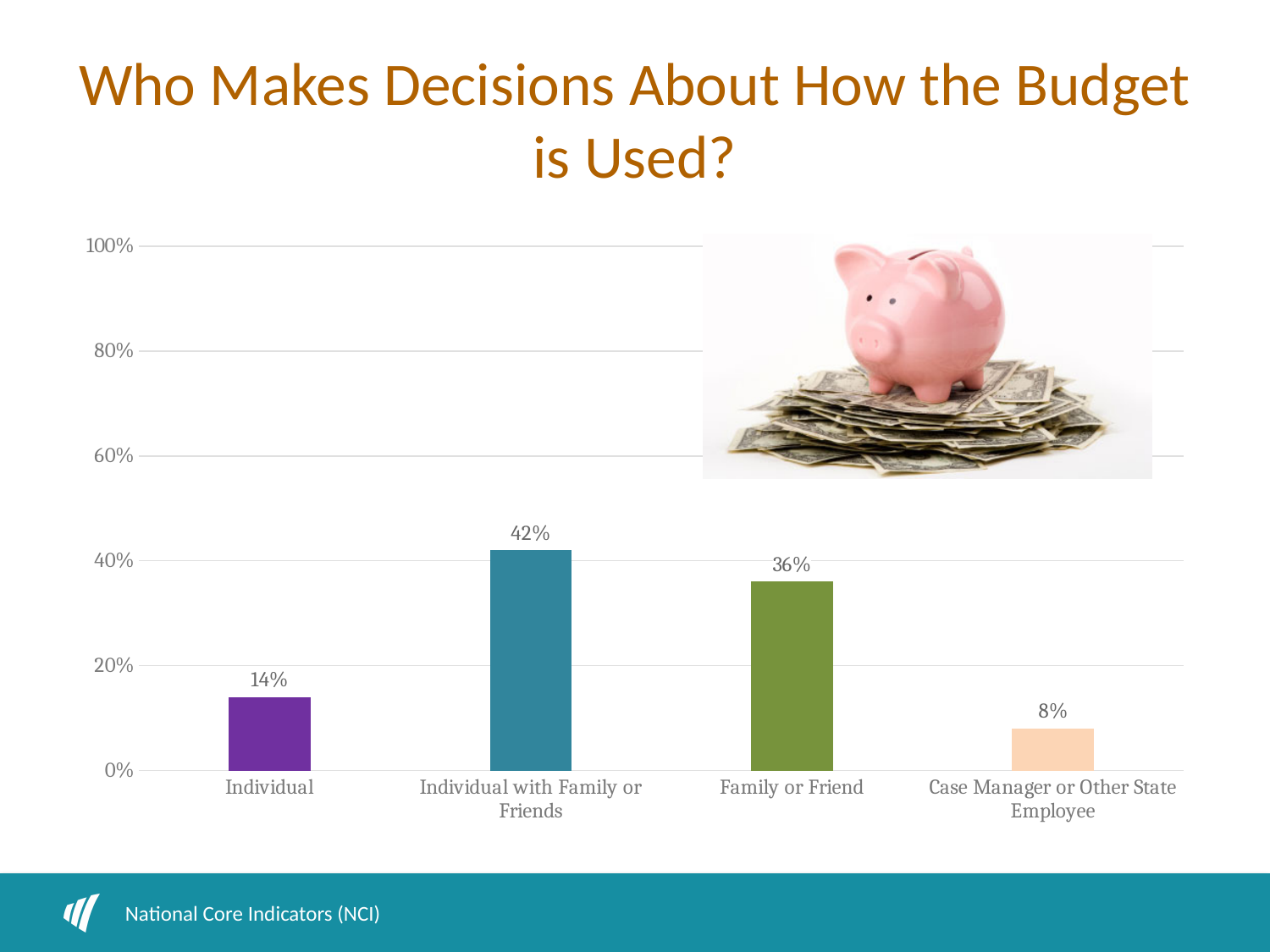
What percentage is shown for Family or Friend? 36% What is the difference between the values for Individual and Case Manager or Other State Employee? 6% What percentage is shown for Individual? 14% Is the value for Family or Friend greater or less than 40%? less Which is larger, the value for Individual or the value for Family or Friend? Family or Friend Which category has the highest value? Individual with Family or Friends What percentage is shown for Case Manager or Other State Employee? 8% What percentage is shown for Individual with Family or Friends? 42% What kind of chart is shown on the slide? Bar chart What is the difference between the values for Individual with Family or Friends and Family or Friend? 6% Which category has the lowest value? Case Manager or Other State Employee How many categories are shown in the chart? 4